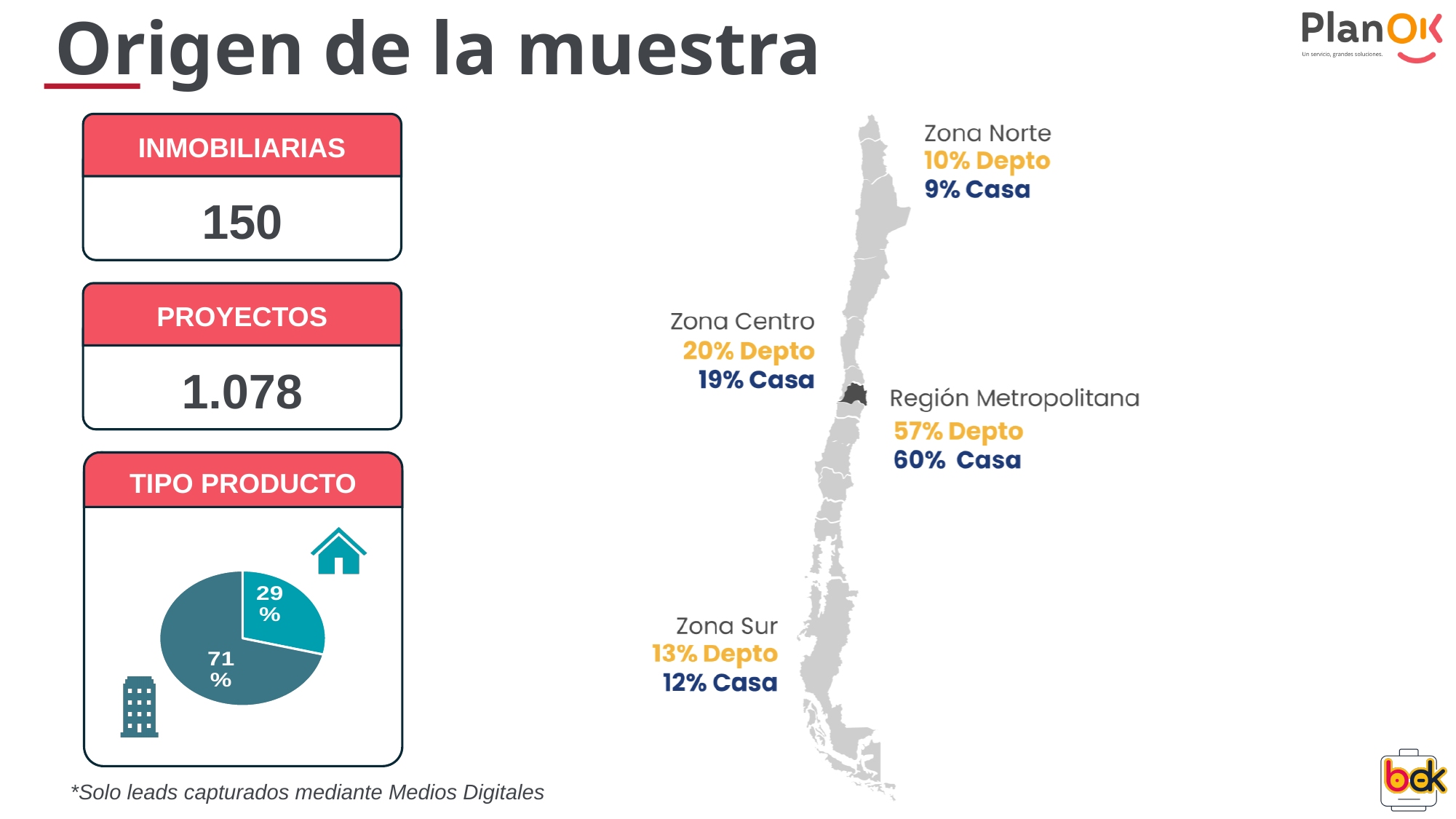
Which icon appears next to the 71% slice of the TIPO PRODUCTO pie chart? a building What is the value of the smallest slice in the TIPO PRODUCTO pie chart? 29% How many slices does the TIPO PRODUCTO pie chart have? 2 What kind of chart is shown in the TIPO PRODUCTO box? pie chart What share of the TIPO PRODUCTO pie does the slice next to the house icon represent? 29% In the TIPO PRODUCTO pie chart, what do the two slice values add up to? 100% What is the value of the largest slice in the TIPO PRODUCTO pie chart? 71% In the TIPO PRODUCTO pie chart, is the slice labelled 29% larger or smaller than the slice labelled 71%? smaller What is the heading of the box that contains the pie chart? TIPO PRODUCTO In the TIPO PRODUCTO pie chart, is the largest slice greater or less than 50%? greater In the TIPO PRODUCTO pie chart, what is the difference between the two slices? 42 percentage points